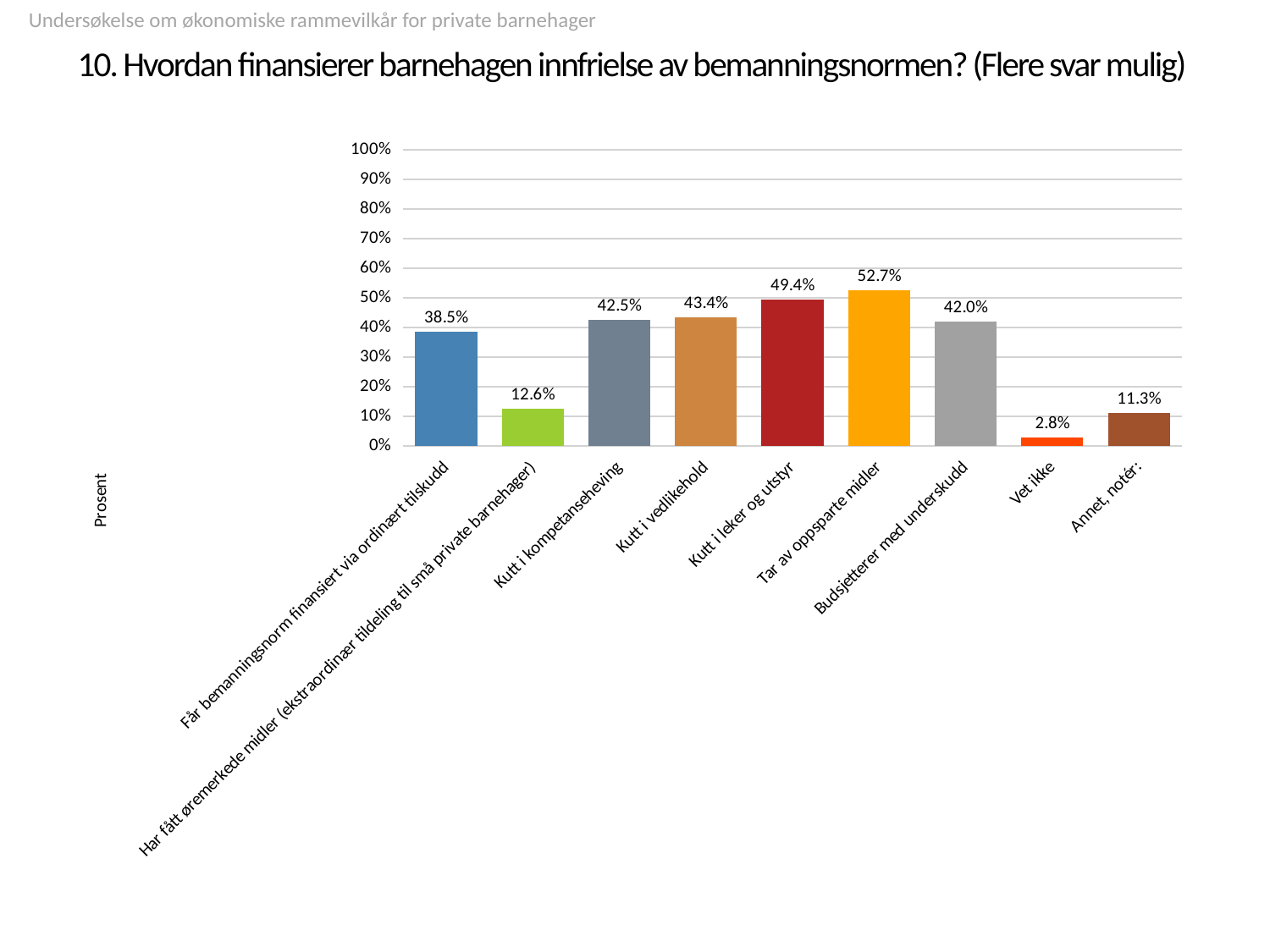
Is the value for "Har fått øremerkede midler (ekstraordinær tildeling til små private barnehager)" greater or less than 20%? less What is the value for "Kutt i vedlikehold"? 43.4% What is the difference between "Kutt i leker og utstyr" and "Kutt i kompetanseheving"? 6.9% What is the label of the vertical axis? Prosent What kind of chart is shown on the slide? bar chart Which is larger: "Budsjetterer med underskudd" or "Annet, notér:"? Budsjetterer med underskudd What is the value for "Tar av oppsparte midler"? 52.7% What is the value for "Vet ikke"? 2.8% Which category has the lowest value? Vet ikke What is the value for "Får bemanningsnorm finansiert via ordinært tilskudd"? 38.5% How many categories are shown in the chart? 9 Which category has the highest value? Tar av oppsparte midler